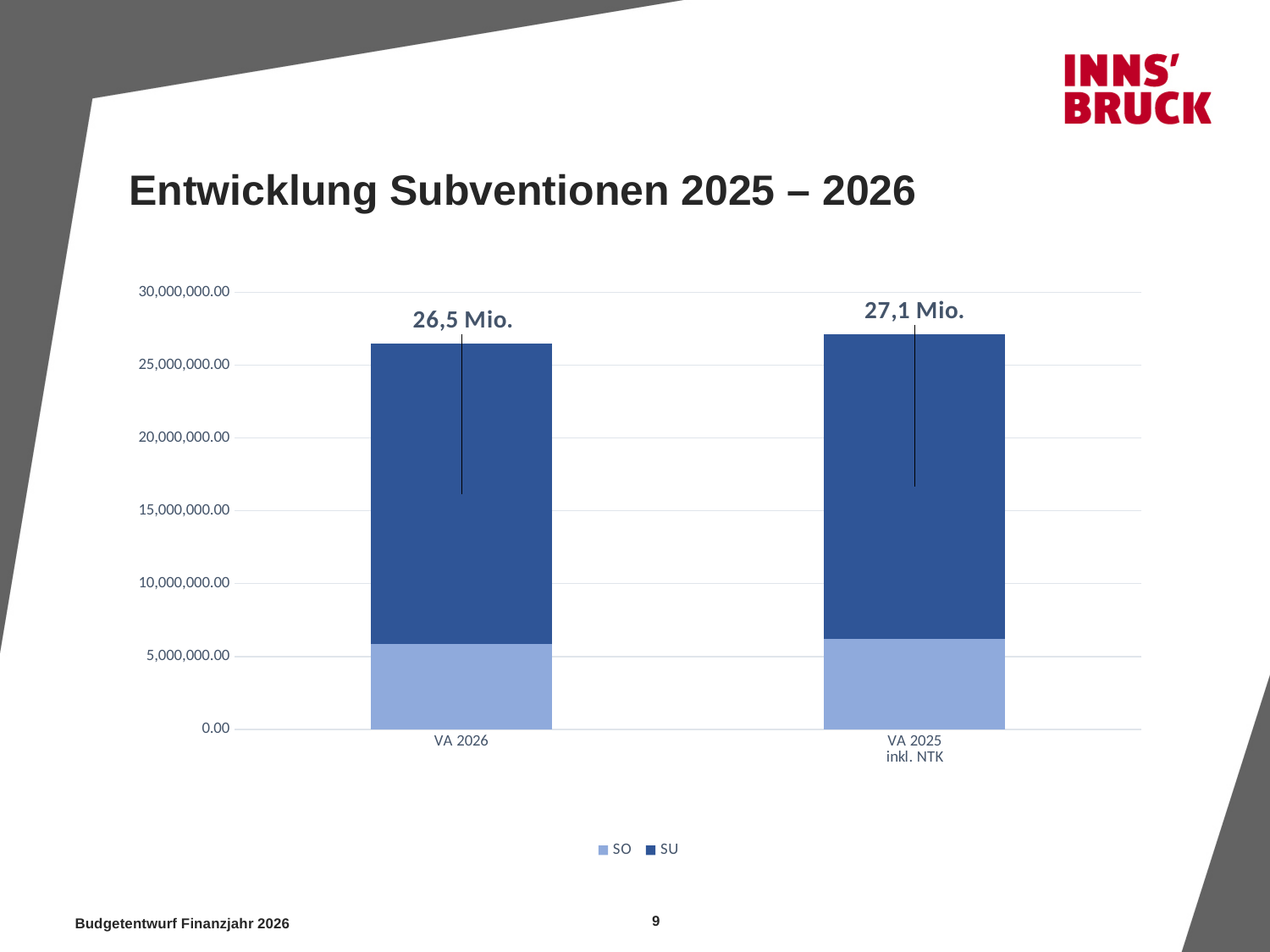
Which series is shown in the lighter blue colour in the legend? SO What is the total value labelled on the VA 2025 inkl. NTK bar? 27,1 Mio. What kind of chart is shown on the slide? Stacked bar chart Is the SO value for VA 2025 inkl. NTK greater or less than 5,000,000.00? greater What is the difference between the labelled totals of VA 2025 inkl. NTK and VA 2026? 0,6 Mio. What is the total value labelled on the VA 2026 bar? 26,5 Mio. What is the title of the slide's chart? Entwicklung Subventionen 2025 – 2026 How many series does the legend list? 2 Which bar has the higher total, VA 2026 or VA 2025 inkl. NTK? VA 2025 inkl. NTK Is the SO value for VA 2026 greater or less than 10,000,000.00? less How many bars (categories) are shown in the chart? 2 Is the SU value for VA 2026 greater or less than 15,000,000.00? greater